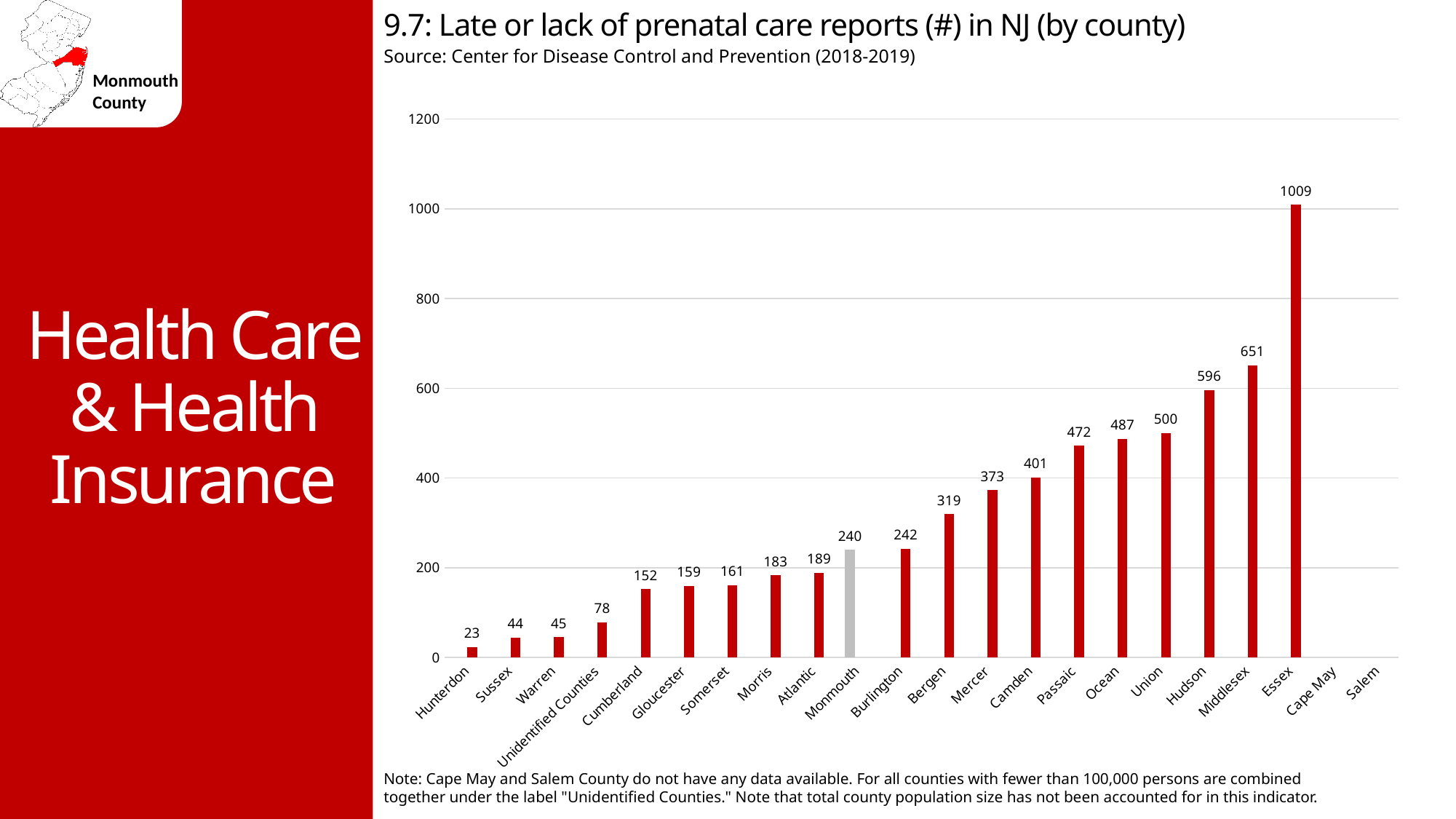
Is the value for Passaic greater or less than 400? greater What is the difference between the values for Essex and Middlesex? 358 What is the number of late or lack of prenatal care reports for Monmouth County? 240 Which county with data shown has the lowest number of reports? Hunterdon What is the difference between the values for Monmouth and Burlington? 2 What kind of chart is shown on the slide? Bar chart What is the value shown for Cumberland County? 152 Which bar is shown in grey rather than red? Monmouth Which county has the highest number of late or lack of prenatal care reports? Essex Which has a higher value, Hudson or Union? Hudson How many county categories are listed on the x axis, including Unidentified Counties? 22 What is the value shown for Essex County? 1009